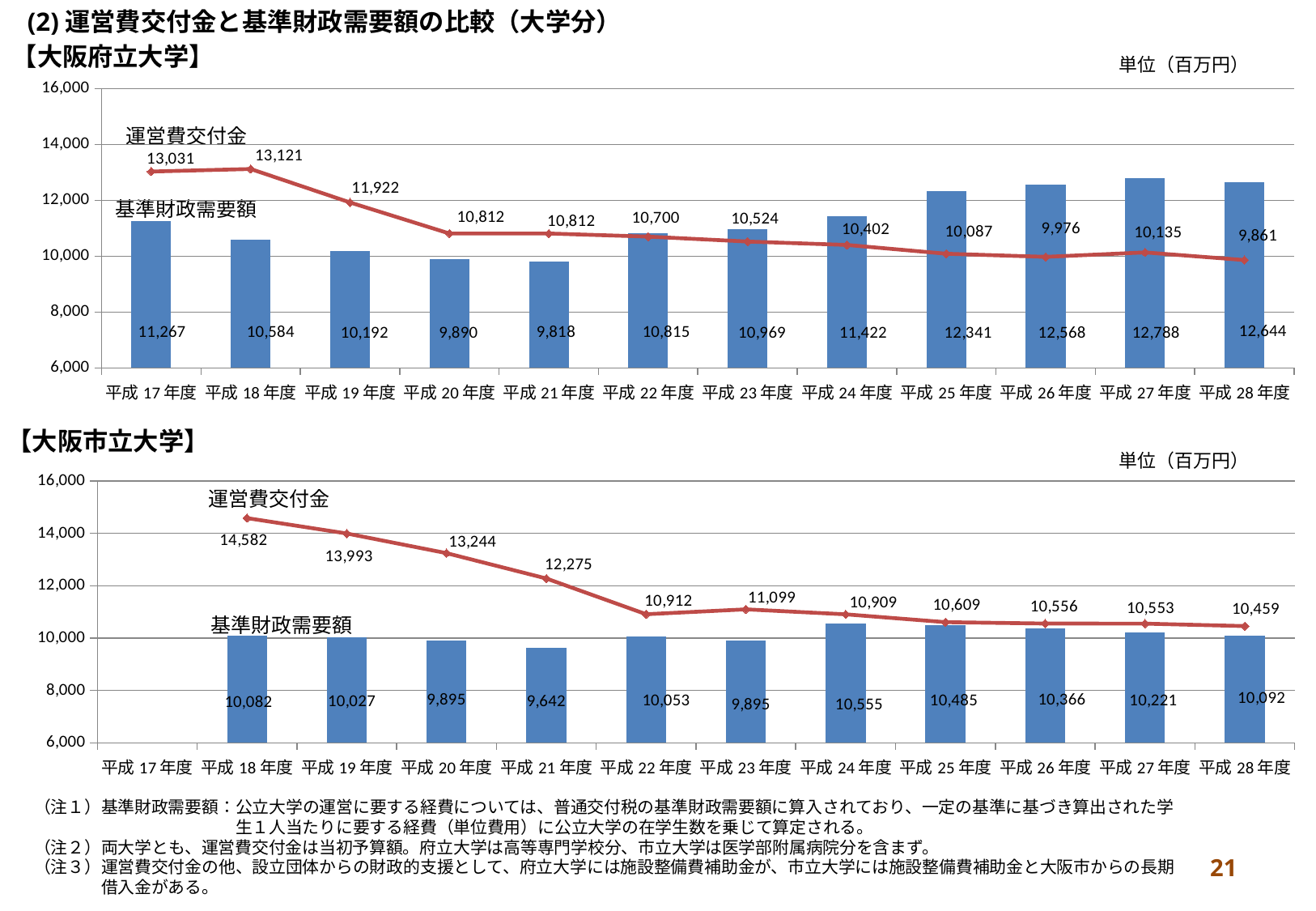
In the 【大阪府立大学】 chart, how many fiscal years are shown on the x axis? 12 In the 【大阪府立大学】 chart, which year has the lowest 運営費交付金 value? 平成28年度 In the 【大阪市立大学】 chart, which year has the lowest 基準財政需要額 bar? 平成21年度 What unit is stated for the values in both charts? 百万円 In the 【大阪市立大学】 chart, what is the 運営費交付金 value for 平成18年度? 14,582 In the 【大阪府立大学】 chart, which year has the highest 基準財政需要額 bar? 平成27年度 In the 【大阪市立大学】 chart, what is the 基準財政需要額 value for 平成21年度? 9,642 In the 【大阪市立大学】 chart, is 運営費交付金 larger in 平成22年度 or 平成23年度? 平成23年度 In the 【大阪府立大学】 chart, what is the 運営費交付金 value for 平成17年度? 13,031 In the 【大阪府立大学】 chart, what is the difference between 基準財政需要額 and 運営費交付金 in 平成28年度? 2,783 In the 【大阪府立大学】 chart, what is the 基準財政需要額 value for 平成27年度? 12,788 In the 【大阪市立大学】 chart, does the 運営費交付金 line generally rise or fall from 平成18年度 to 平成28年度? fall